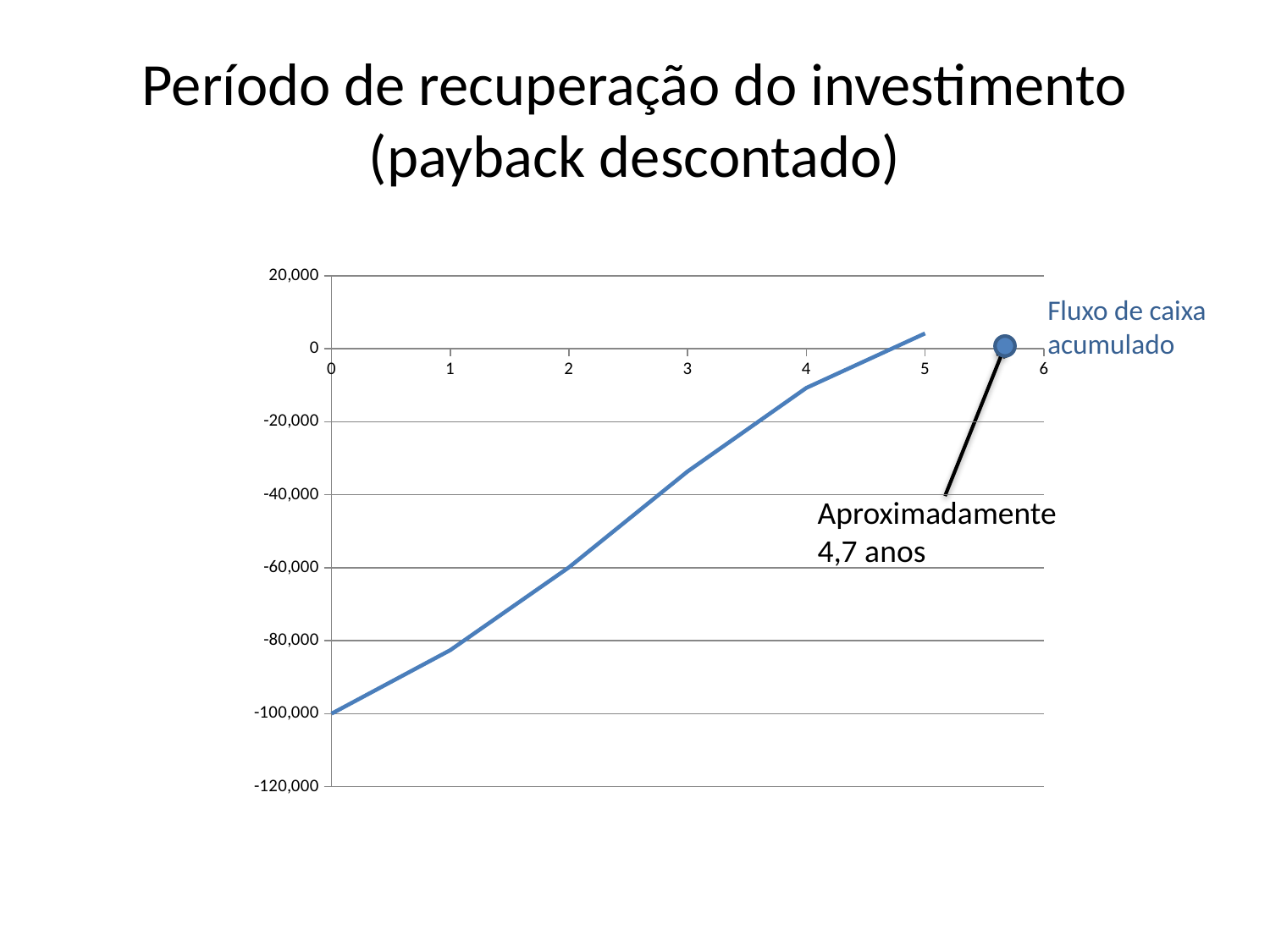
Is the cumulative cash flow at year 1 greater or less than -60,000? less Is the cumulative cash flow at year 5 greater or less than 0? greater At which year is the cumulative cash flow highest? 5 What is the cumulative cash flow value at year 0? -100,000 At which year is the cumulative cash flow lowest? 0 What series name is shown next to the line in the chart? Fluxo de caixa acumulado What kind of chart is shown on the slide? line chart Which year has the larger cumulative cash flow, year 2 or year 4? 4 Is the cumulative cash flow at year 3 greater or less than -40,000? greater Does the cumulative cash flow line rise or fall as the year increases from 0 to 5? rise What is the title of the slide's chart? Período de recuperação do investimento (payback descontado)